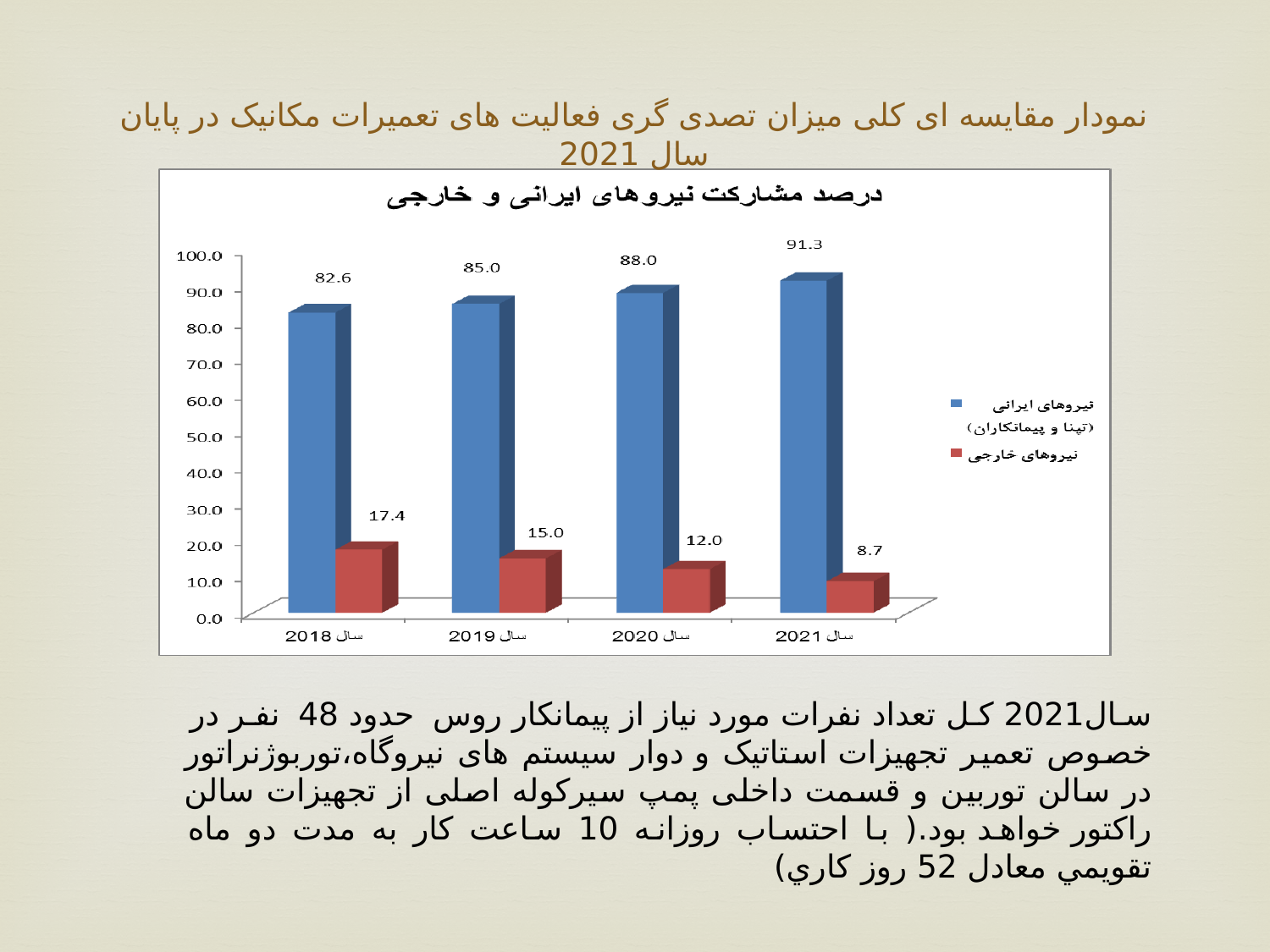
Do the values for نیروهای خارجی (foreign forces) rise or fall from سال 2018 to سال 2021? Fall What is the value for نیروهای ایرانی (Iranian forces) in سال 2021? 91.3 Which is larger: the نیروهای خارجی value in سال 2018 or in سال 2019? سال 2018 How many series does the legend list? 2 What is the value for نیروهای خارجی (foreign forces) in سال 2020? 12.0 What is the difference between the نیروهای ایرانی value and the نیروهای خارجی value in سال 2020? 76.0 How many years (categories) are shown on the x axis? 4 What is the value for نیروهای خارجی (foreign forces) in سال 2018? 17.4 What kind of chart is shown on the slide? Bar chart What is the value for نیروهای ایرانی (Iranian forces) in سال 2019? 85.0 In which year is the value for نیروهای خارجی (foreign forces) lowest? سال 2021 In which year is the value for نیروهای ایرانی (Iranian forces) highest? سال 2021